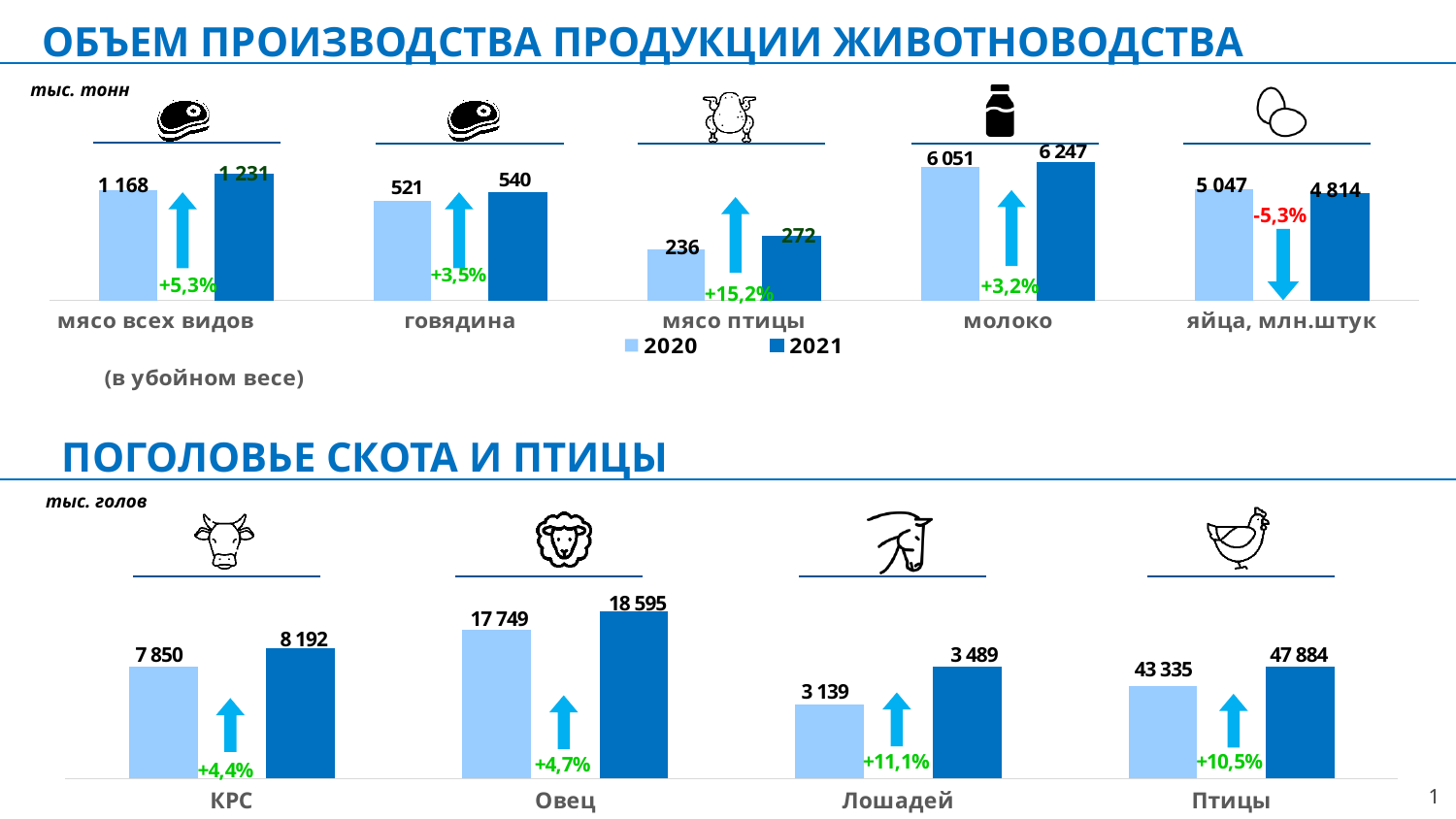
In the bottom chart 'ПОГОЛОВЬЕ СКОТА И ПТИЦЫ', what is the 2021 value for 'Овец'? 18 595 In the top chart 'ОБЪЕМ ПРОИЗВОДСТВА ПРОДУКЦИИ ЖИВОТНОВОДСТВА', is the 2021 value for 'яйца, млн.штук' larger or smaller than its 2020 value? smaller How many series does the legend of the top chart 'ОБЪЕМ ПРОИЗВОДСТВА ПРОДУКЦИИ ЖИВОТНОВОДСТВА' list? 2 In the bottom chart 'ПОГОЛОВЬЕ СКОТА И ПТИЦЫ', which category has the highest 2021 value? Птицы In the top chart 'ОБЪЕМ ПРОИЗВОДСТВА ПРОДУКЦИИ ЖИВОТНОВОДСТВА', what is the 2021 value for 'молоко'? 6 247 What kind of chart is the bottom chart 'ПОГОЛОВЬЕ СКОТА И ПТИЦЫ'? bar chart How many categories are shown in the bottom chart 'ПОГОЛОВЬЕ СКОТА И ПТИЦЫ'? 4 In the top chart 'ОБЪЕМ ПРОИЗВОДСТВА ПРОДУКЦИИ ЖИВОТНОВОДСТВА', what is the 2020 value for 'мясо птицы'? 236 In the top chart 'ОБЪЕМ ПРОИЗВОДСТВА ПРОДУКЦИИ ЖИВОТНОВОДСТВА', what is the difference between the 2021 and 2020 values for 'говядина'? 19 In the bottom chart 'ПОГОЛОВЬЕ СКОТА И ПТИЦЫ', what is the difference between the 2021 and 2020 values for 'Лошадей'? 350 In the top chart 'ОБЪЕМ ПРОИЗВОДСТВА ПРОДУКЦИИ ЖИВОТНОВОДСТВА', which category has the lowest 2020 value? мясо птицы In the top chart 'ОБЪЕМ ПРОИЗВОДСТВА ПРОДУКЦИИ ЖИВОТНОВОДСТВА', what percentage change is shown for 'мясо птицы'? +15,2%